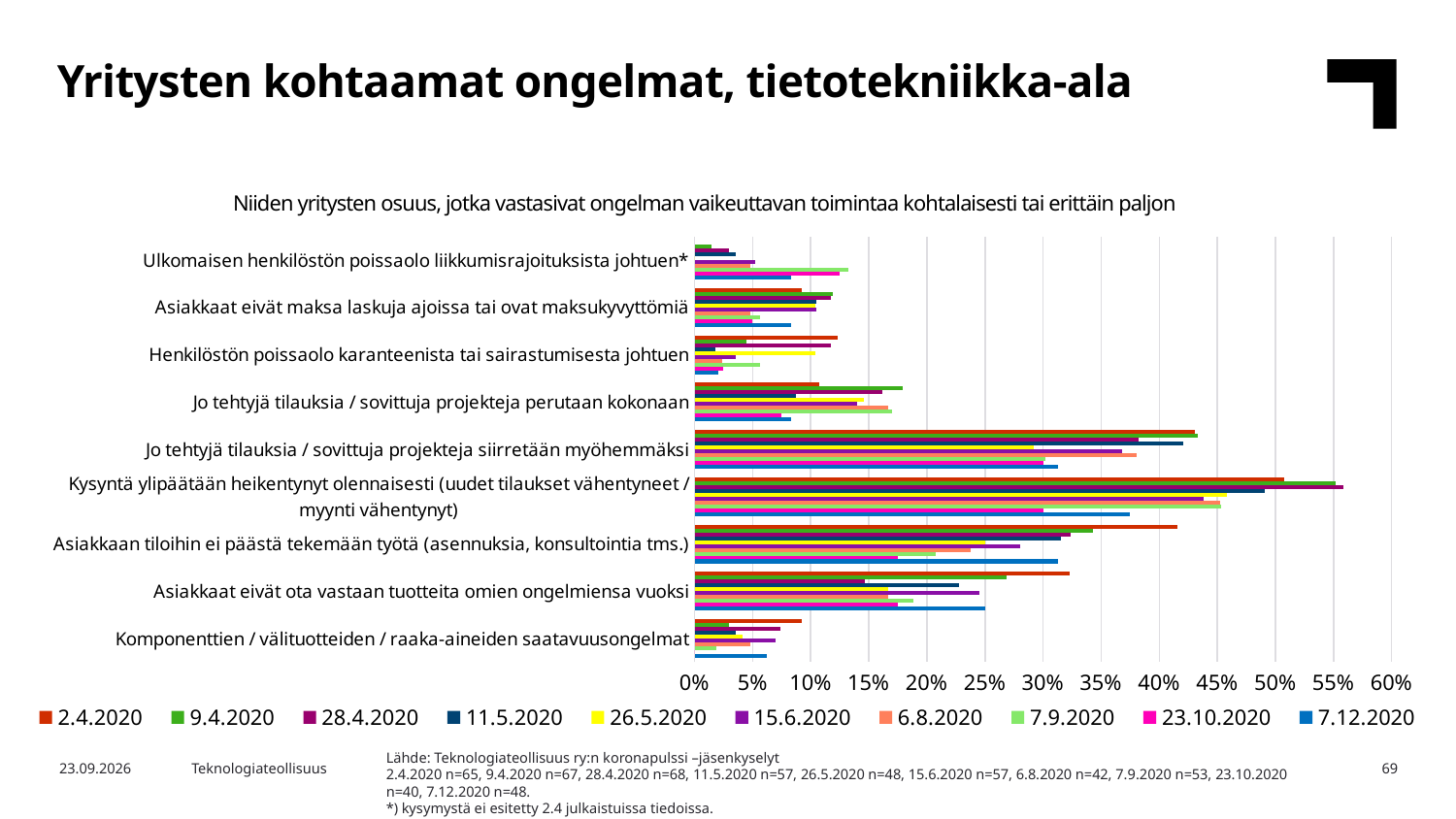
How many series (survey dates) does the legend list? 10 Which category has the shortest bars overall on the chart? Komponenttien / välituotteiden / raaka-aineiden saatavuusongelmat Which category has the longest bars overall on the chart? Kysyntä ylipäätään heikentynyt olennaisesti (uudet tilaukset vähentyneet / myynti vähentynyt) Is the value for 'Asiakkaat eivät ota vastaan tuotteita omien ongelmiensa vuoksi' on 2.4.2020 greater or less than 30%? greater Is the value for 'Kysyntä ylipäätään heikentynyt olennaisesti' on 9.4.2020 greater or less than 50%? greater What is the first survey date listed in the chart legend? 2.4.2020 Is the value for 'Komponenttien / välituotteiden / raaka-aineiden saatavuusongelmat' on 2.4.2020 greater or less than 10%? less For 2.4.2020, which is larger: the value for 'Kysyntä ylipäätään heikentynyt olennaisesti' or for 'Komponenttien / välituotteiden / raaka-aineiden saatavuusongelmat'? Kysyntä ylipäätään heikentynyt olennaisesti How many problem categories are listed on the chart's vertical axis? 9 What is the highest value shown on the chart's horizontal axis? 60% What kind of chart is shown on the slide? bar chart